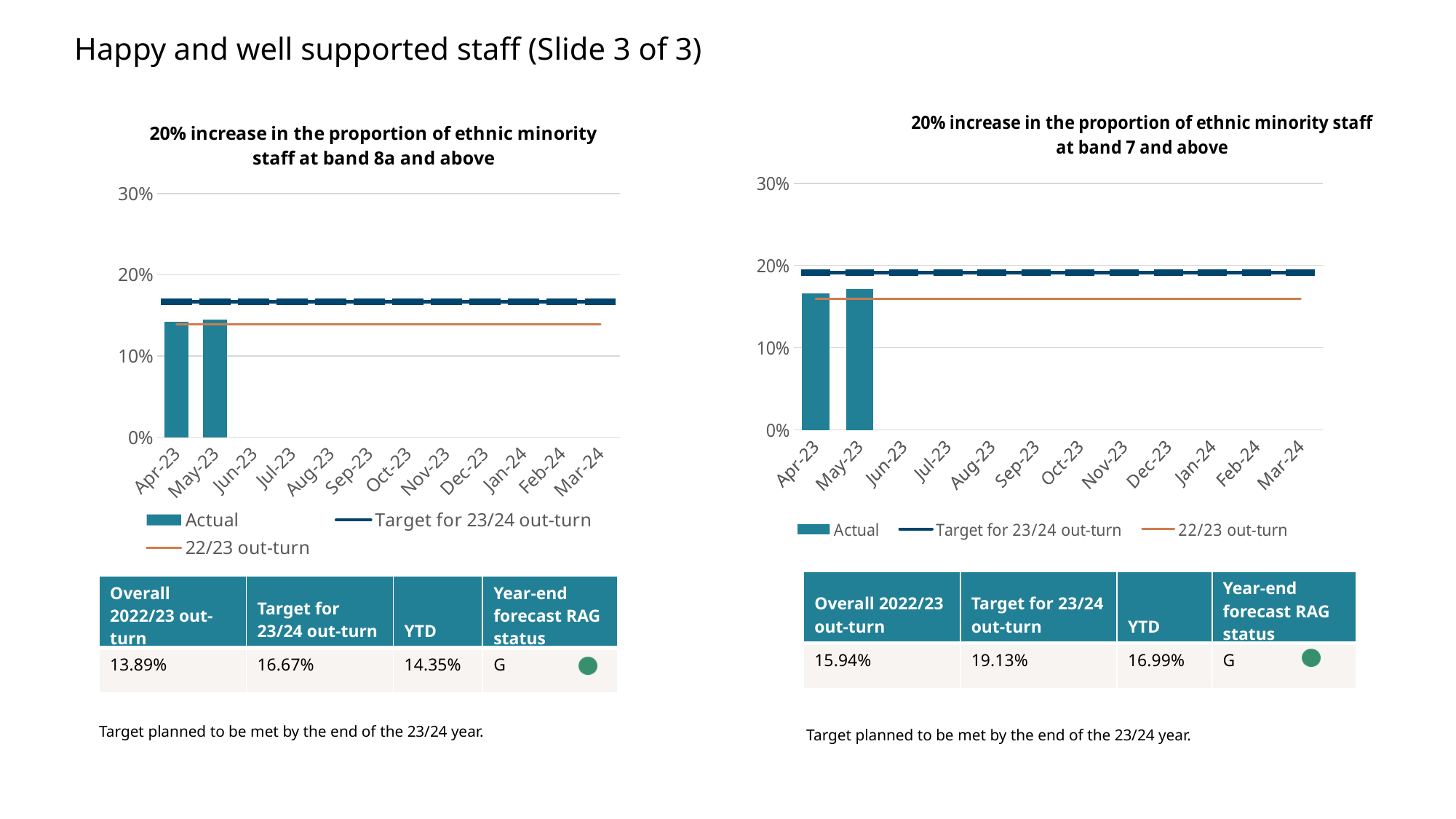
How many months have an Actual bar plotted on the right chart (band 7 and above)? 2 On the right chart (band 7 and above), is the Target for 23/24 out-turn line above or below the 22/23 out-turn line? above On the right chart (band 7 and above), which month has the highest Actual bar? May-23 On the right chart (band 7 and above), is the value for Apr-23 greater or less than 20%? less On the left chart (band 8a and above), is the value for May-23 greater or less than 20%? less How many months are shown on the x axis of the left chart (band 8a and above)? 12 On the left chart (band 8a and above), is the value for Apr-23 greater or less than 10%? greater What is the title of the left chart? 20% increase in the proportion of ethnic minority staff at band 8a and above How many series does the legend of the left chart (band 8a and above) list? 3 What kind of chart is the right chart (band 7 and above)? combination bar and line chart On the right chart (band 7 and above), which month has the higher Actual bar, Apr-23 or May-23? May-23